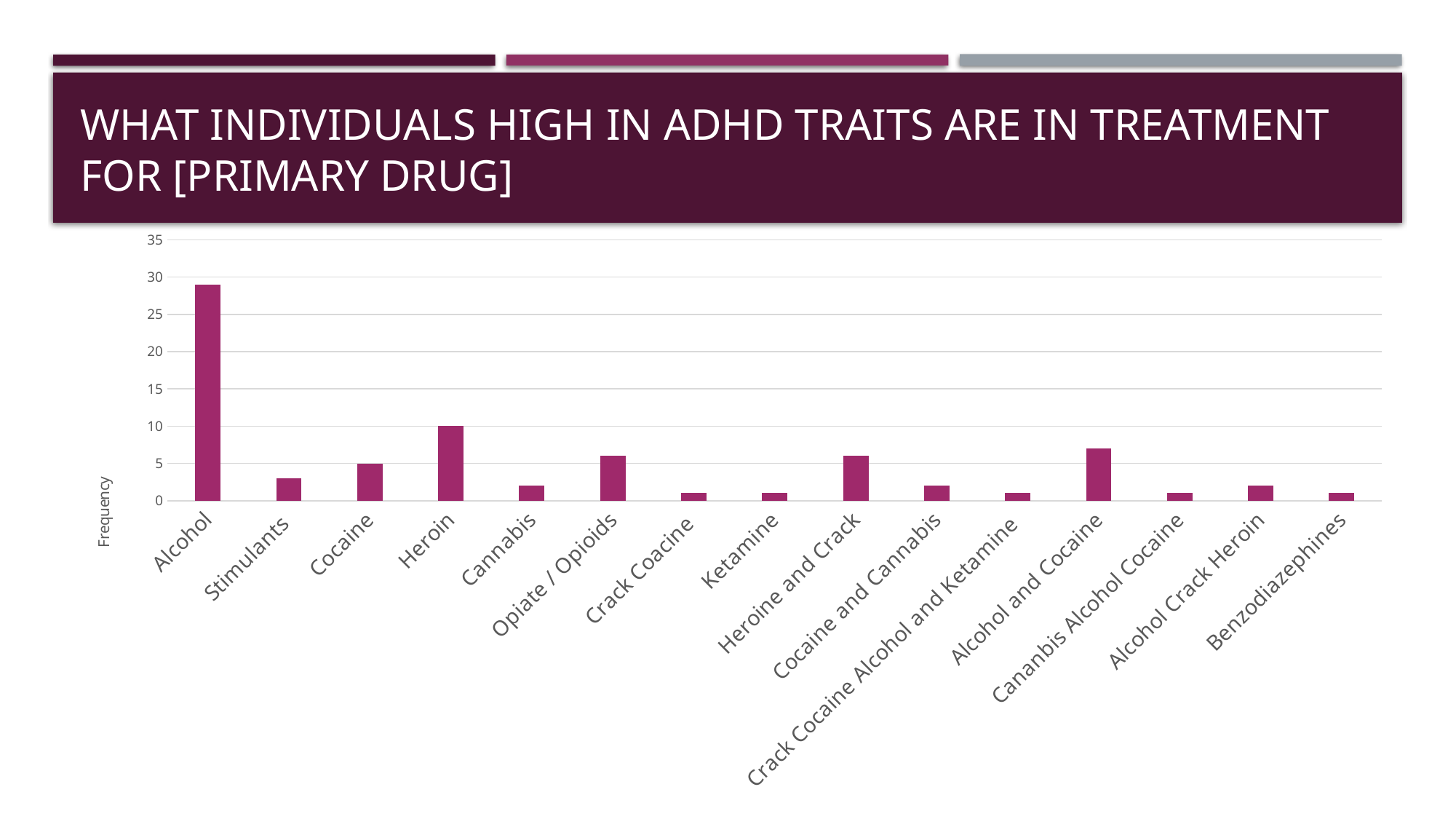
What is the label on the vertical axis of the chart? Frequency Is the value for Stimulants greater or less than 5? less Is the value for Cannabis greater or less than 5? less What is the frequency for Heroin? 10 Which has a higher frequency, Alcohol and Cocaine or Stimulants? Alcohol and Cocaine Which has a higher frequency, Heroin or Cocaine? Heroin How many primary drug categories are shown on the x axis? 15 What is the frequency for Cocaine? 5 Is the value for Alcohol greater or less than 25? greater Which primary drug category has the highest frequency? Alcohol What kind of chart is shown on the slide? Bar chart